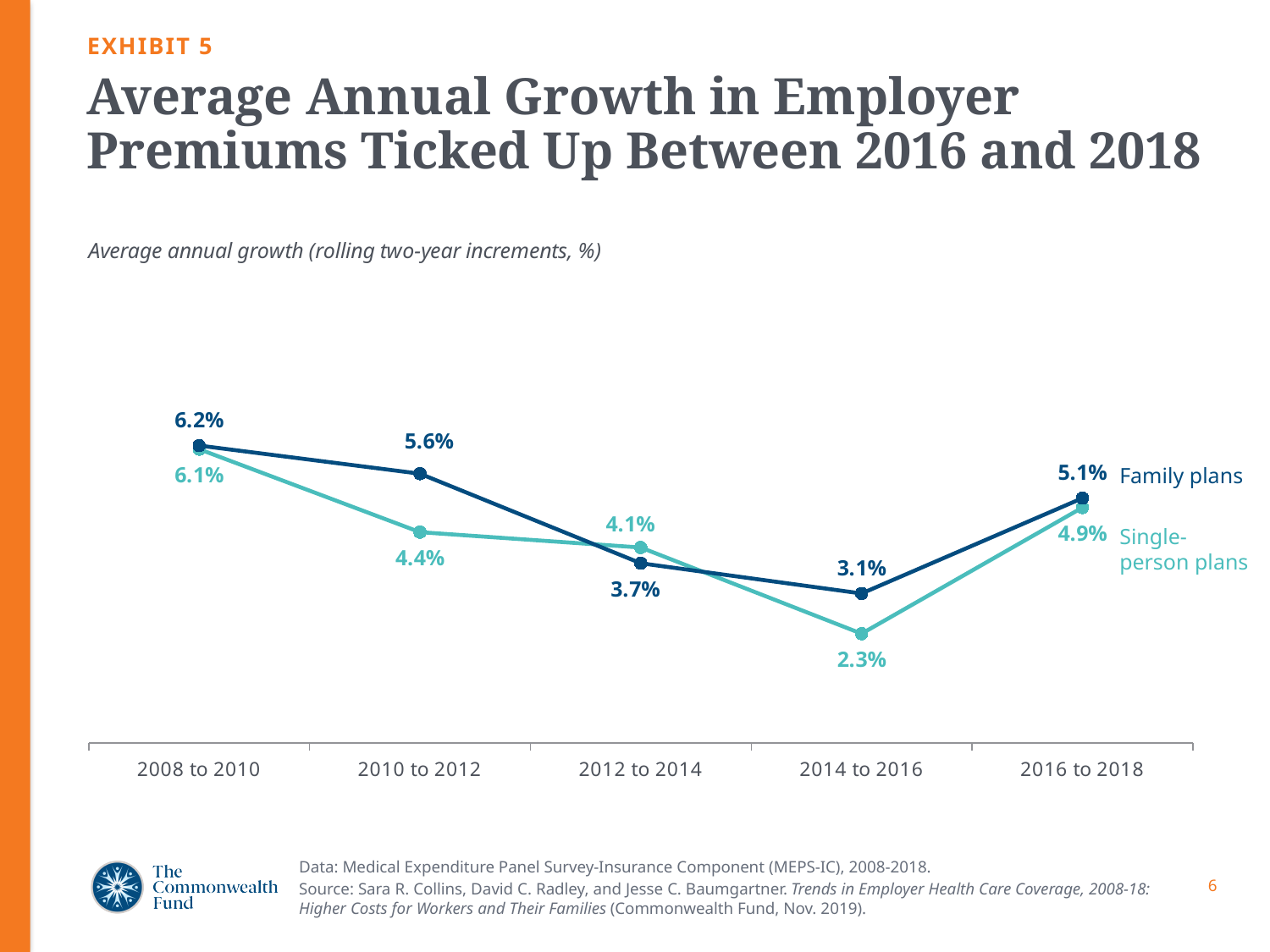
What is the average annual growth for Family plans in 2008 to 2010? 6.2% What is the value for Family plans in 2016 to 2018? 5.1% How many time periods are shown on the x axis? 5 In which period is the Single-person plans growth rate highest? 2008 to 2010 Which series has the larger value in 2012 to 2014, Family plans or Single-person plans? Single-person plans What is the difference between Family plans and Single-person plans in 2010 to 2012? 1.2% Does the Family plans growth rate rise or fall from 2008 to 2010 through 2014 to 2016? Fall How many series are plotted on the chart? 2 In which period is the Family plans growth rate lowest? 2014 to 2016 What is the average annual growth for Single-person plans in 2014 to 2016? 2.3% What kind of chart is shown on the slide? Line chart What is the value for Single-person plans in 2010 to 2012? 4.4%